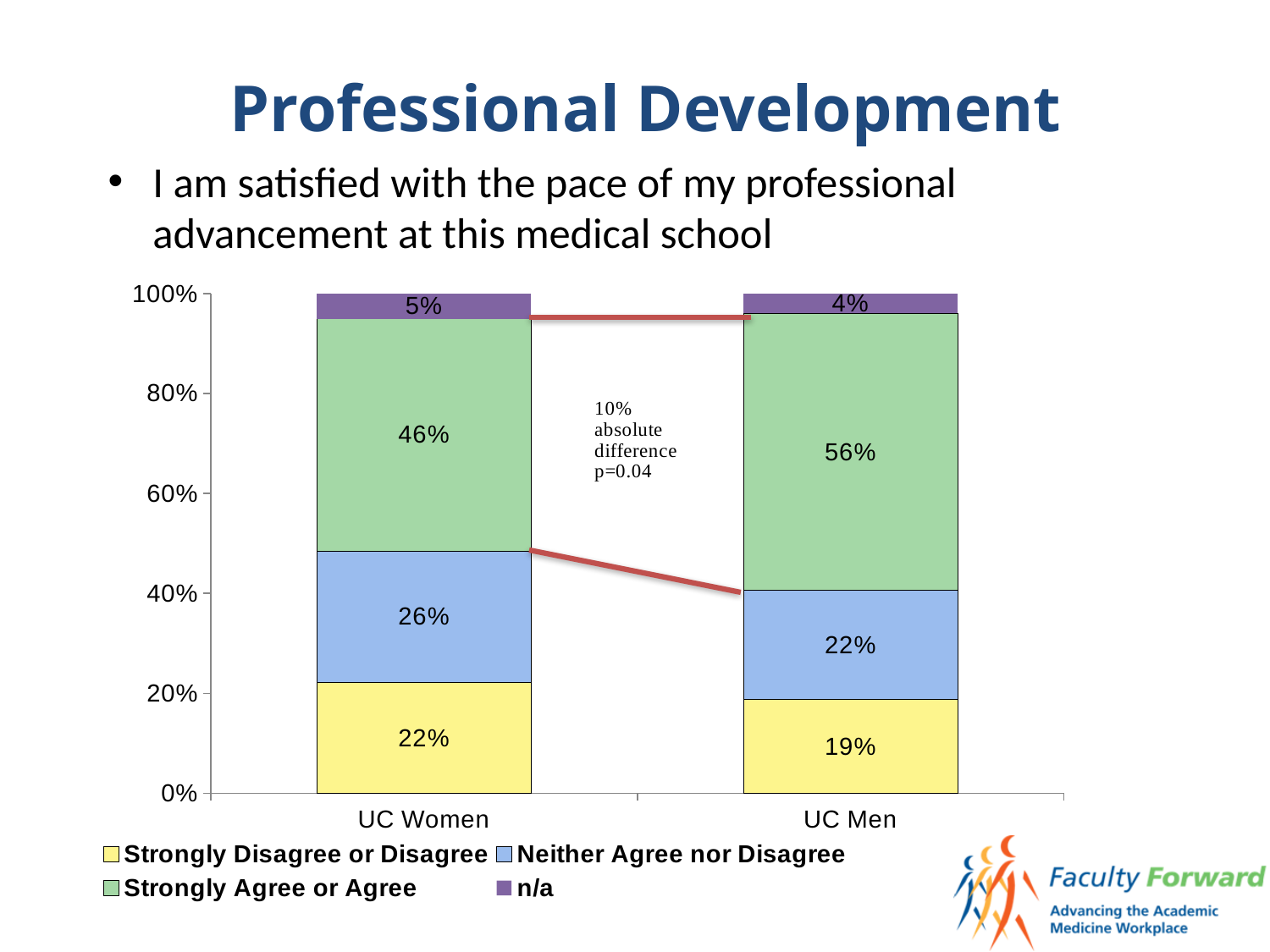
What percentage of UC Women responded 'Neither Agree nor Disagree'? 26% Which group has the larger 'Strongly Disagree or Disagree' share, UC Women or UC Men? UC Women How many series does the legend list? 4 What is the 'n/a' percentage for UC Men? 4% Which group has the larger 'Neither Agree nor Disagree' share, UC Women or UC Men? UC Women What percentage of UC Men responded 'Strongly Agree or Agree'? 56% What is the p-value annotated between the two bars? p=0.04 What is the difference between the 'Strongly Agree or Agree' percentages for UC Men and UC Women? 10% How many groups (categories) are shown on the x axis? 2 What kind of chart is shown on the slide? Stacked bar chart What percentage of UC Women responded 'Strongly Agree or Agree'? 46% What percentage of UC Men responded 'Strongly Disagree or Disagree'? 19%